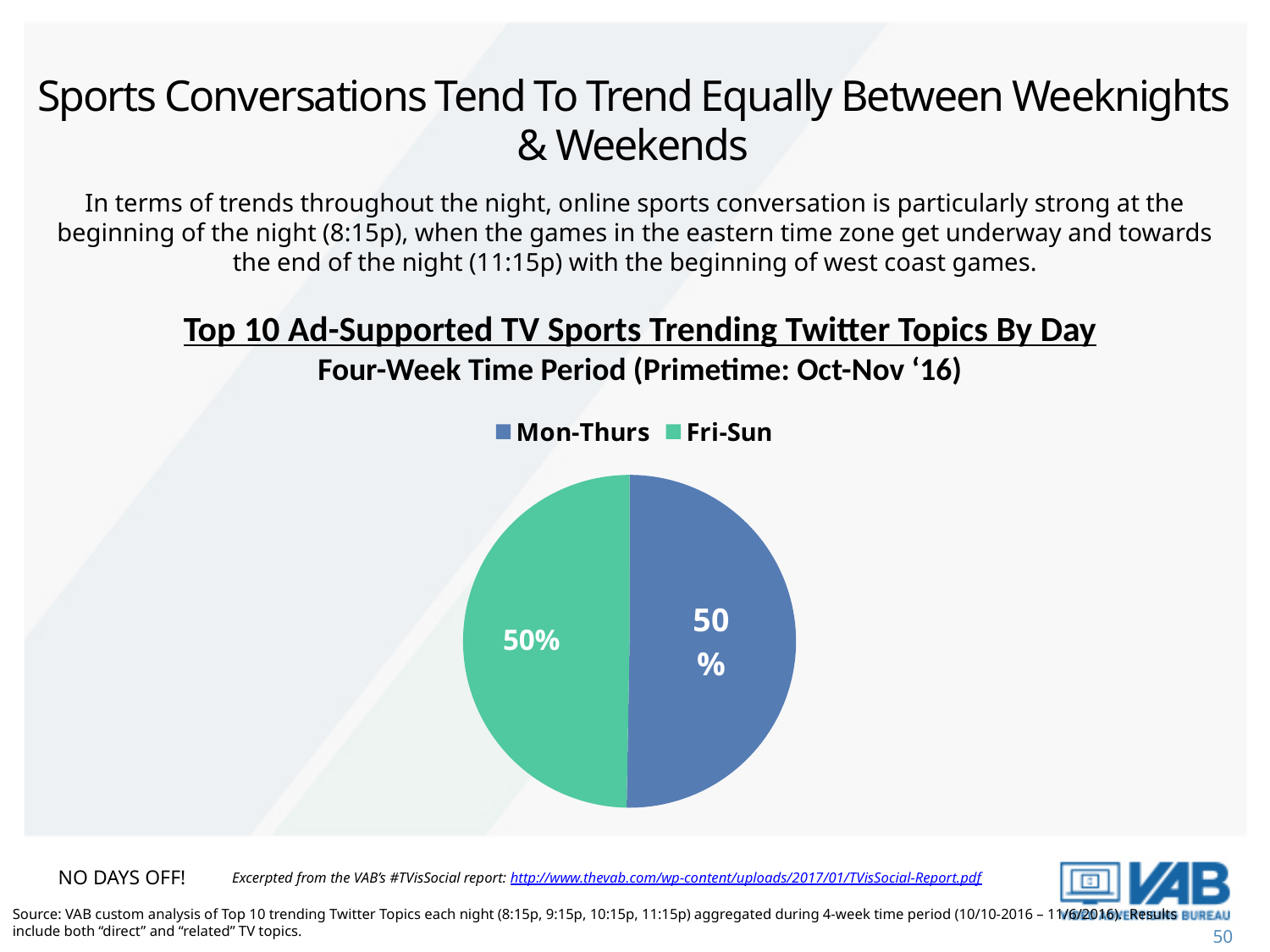
What share of the pie does Fri-Sun account for? 50% What is the value shown for the Fri-Sun slice? 50% What share of the pie does Mon-Thurs account for? 50% How many entries does the legend list? 2 Which legend entry is shown in green? Fri-Sun What kind of chart is shown on the slide? pie chart What is the difference between the Mon-Thurs and Fri-Sun shares? 0% How many slices does the pie chart have? 2 What is the title of the chart? Top 10 Ad-Supported TV Sports Trending Twitter Topics By Day What is the value shown for the Mon-Thurs slice? 50% What is the combined total of the Mon-Thurs and Fri-Sun slices? 100%